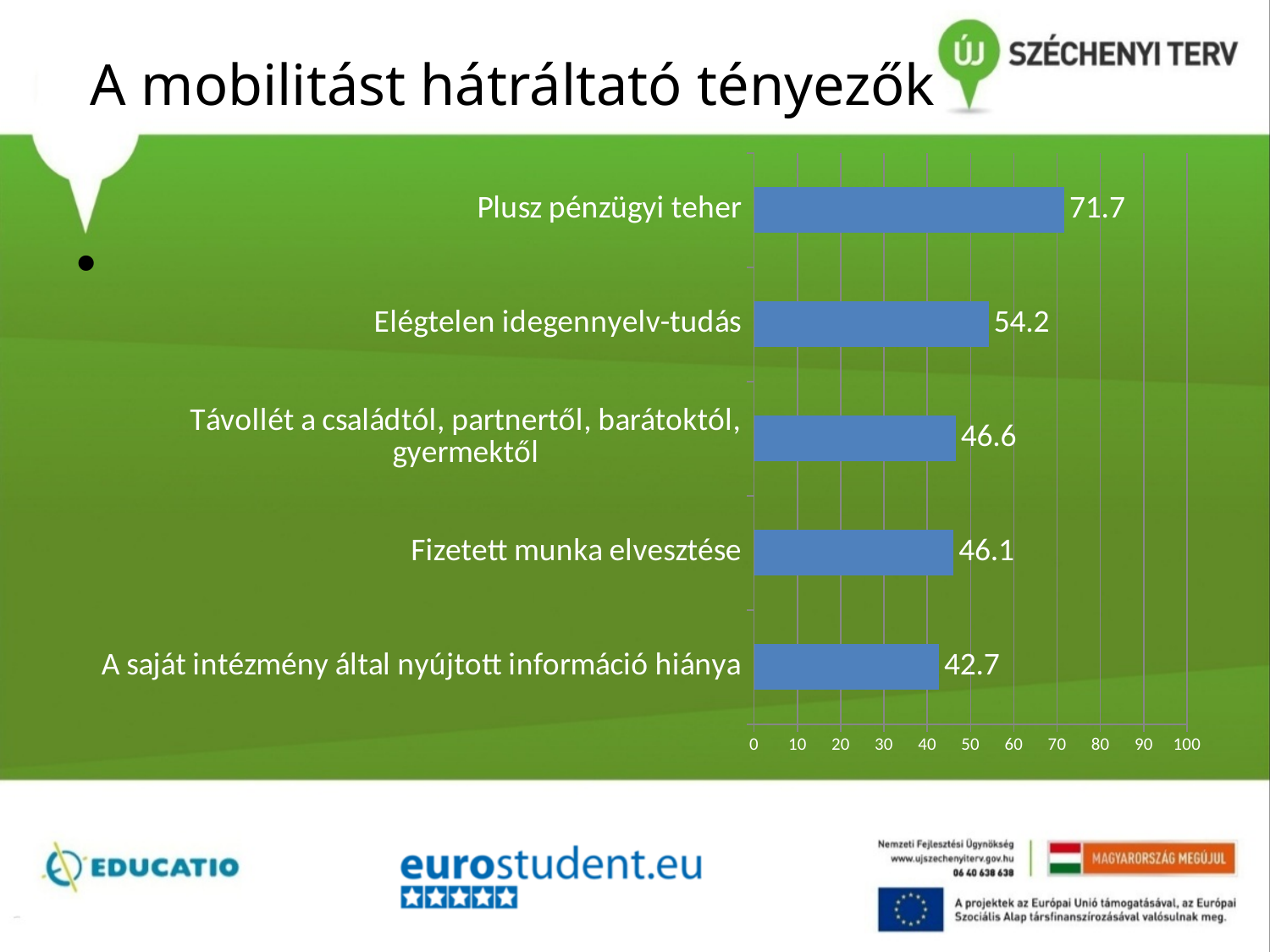
How many categories are shown in the chart? 5 What is the difference between the values for Távollét a családtól, partnertől, barátoktól, gyermektől and A saját intézmény által nyújtott információ hiánya? 3.9 Which category has the lowest value? A saját intézmény által nyújtott információ hiánya Is the value for Plusz pénzügyi teher greater or less than 70? greater What is the value for Elégtelen idegennyelv-tudás? 54.2 What kind of chart is shown on the slide? bar chart What is the difference between the values for Plusz pénzügyi teher and Elégtelen idegennyelv-tudás? 17.5 What is the value for A saját intézmény által nyújtott információ hiánya? 42.7 Which category has the highest value? Plusz pénzügyi teher What is the value for Plusz pénzügyi teher? 71.7 Which is larger: the value for Elégtelen idegennyelv-tudás or the value for Fizetett munka elvesztése? Elégtelen idegennyelv-tudás What is the value for Fizetett munka elvesztése? 46.1